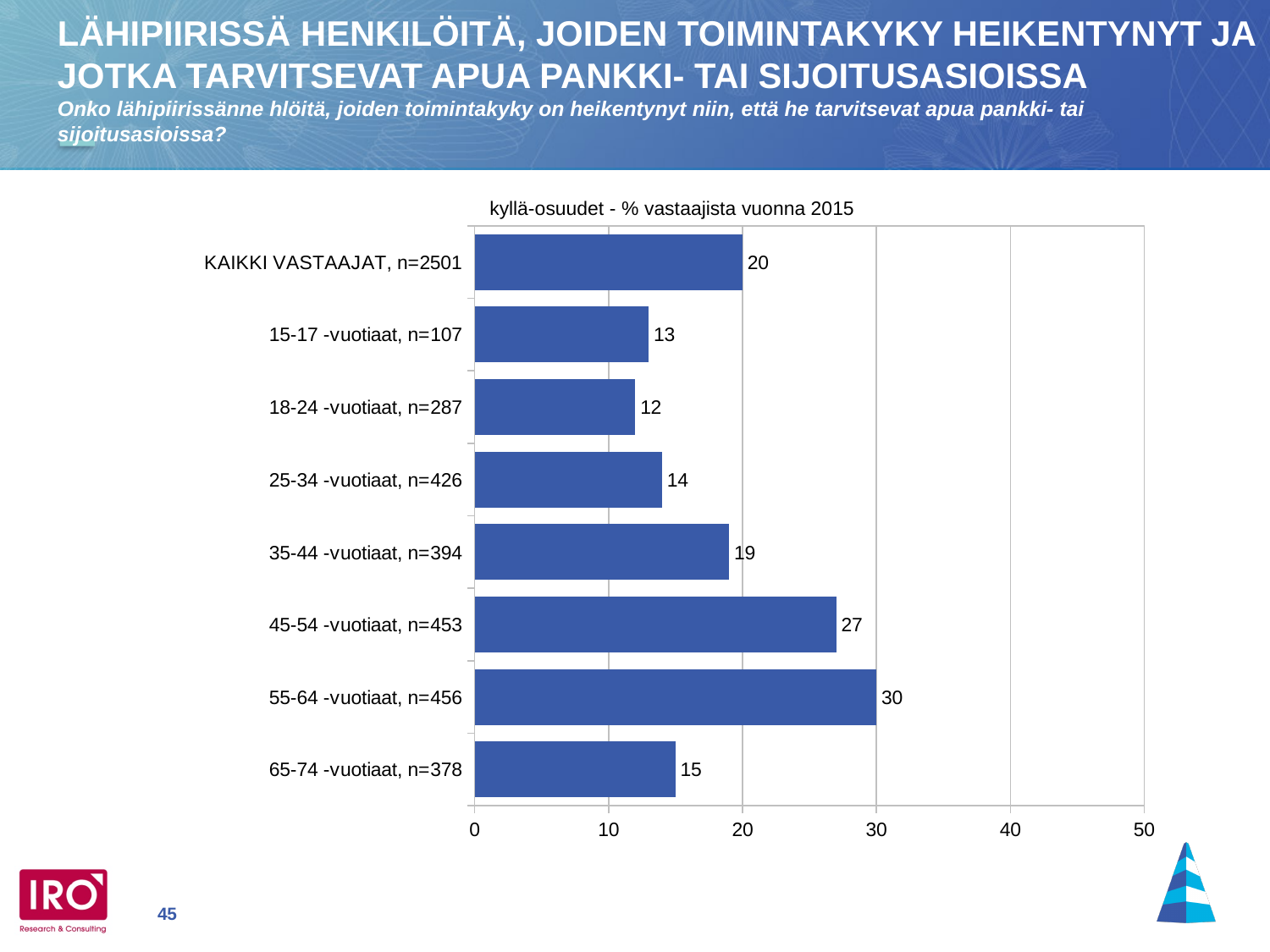
Which is larger, the value for 35-44 -vuotiaat, n=394 or the value for 65-74 -vuotiaat, n=378? 35-44 -vuotiaat, n=394 Is the value for 45-54 -vuotiaat, n=453 greater or less than 20? greater What is the value for 18-24 -vuotiaat, n=287? 12 What is the title of the chart? kyllä-osuudet - % vastaajista vuonna 2015 What is the maximum value shown on the horizontal axis? 50 What is the difference between the values for 55-64 -vuotiaat, n=456 and 45-54 -vuotiaat, n=453? 3 What is the value for 55-64 -vuotiaat, n=456? 30 What kind of chart is shown on the slide? bar chart Which category has the lowest value? 18-24 -vuotiaat, n=287 Which category has the highest value? 55-64 -vuotiaat, n=456 How many categories are shown in the chart? 8 What is the value for KAIKKI VASTAAJAT, n=2501? 20